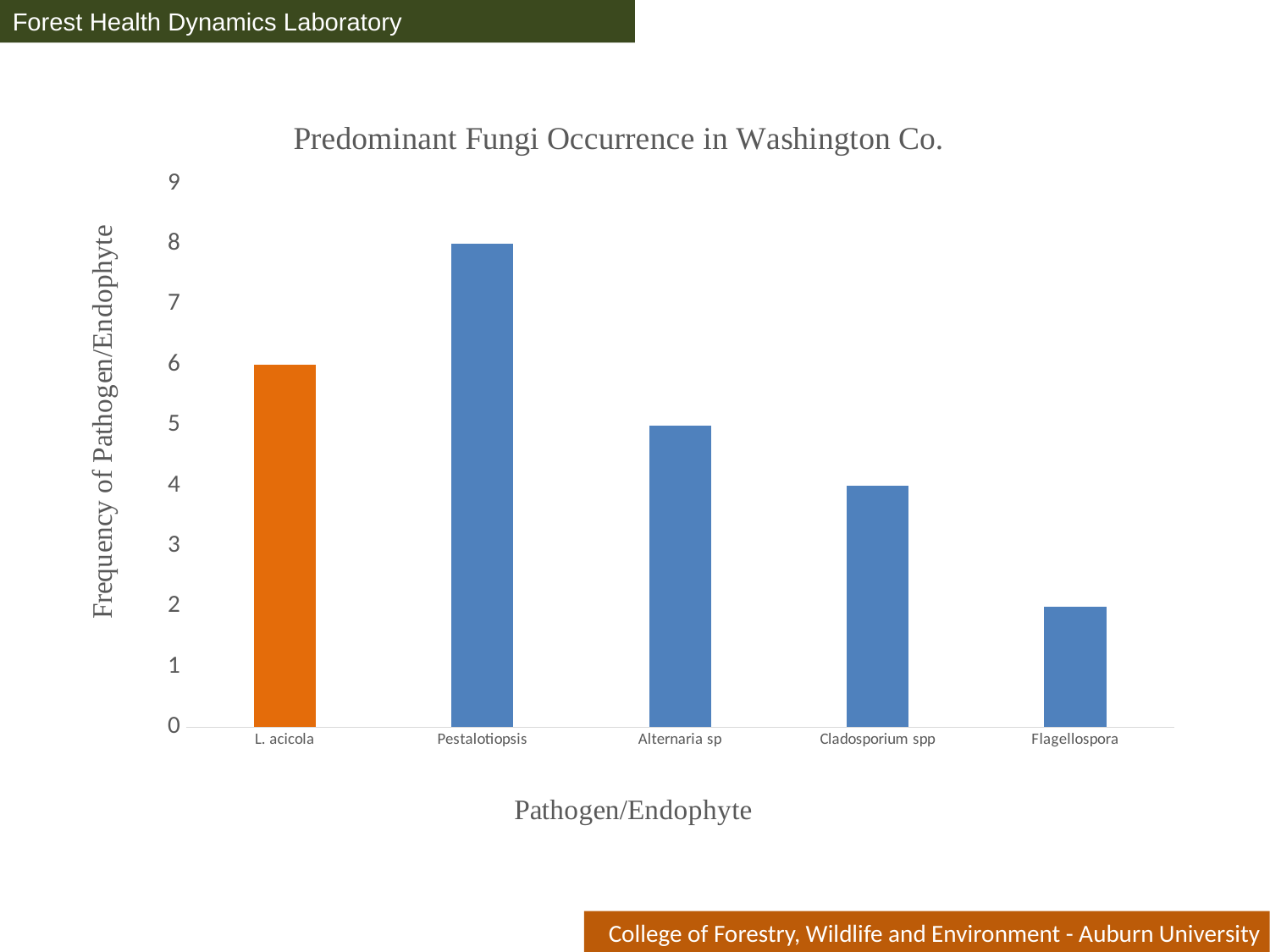
Which pathogen/endophyte has the highest frequency? Pestalotiopsis What is the frequency value for L. acicola? 6 How many pathogen/endophyte categories are plotted in the chart? 5 What is the frequency value for Flagellospora? 2 What is the difference in frequency between Pestalotiopsis and Cladosporium spp? 4 What is the frequency value for Pestalotiopsis? 8 Which bar is coloured orange rather than blue? L. acicola What is the title of the chart? Predominant Fungi Occurrence in Washington Co. Is the value for Alternaria sp greater or less than 3? greater What type of chart is shown on the slide? bar chart Which has a higher frequency, Alternaria sp or Cladosporium spp? Alternaria sp Which pathogen/endophyte has the lowest frequency? Flagellospora